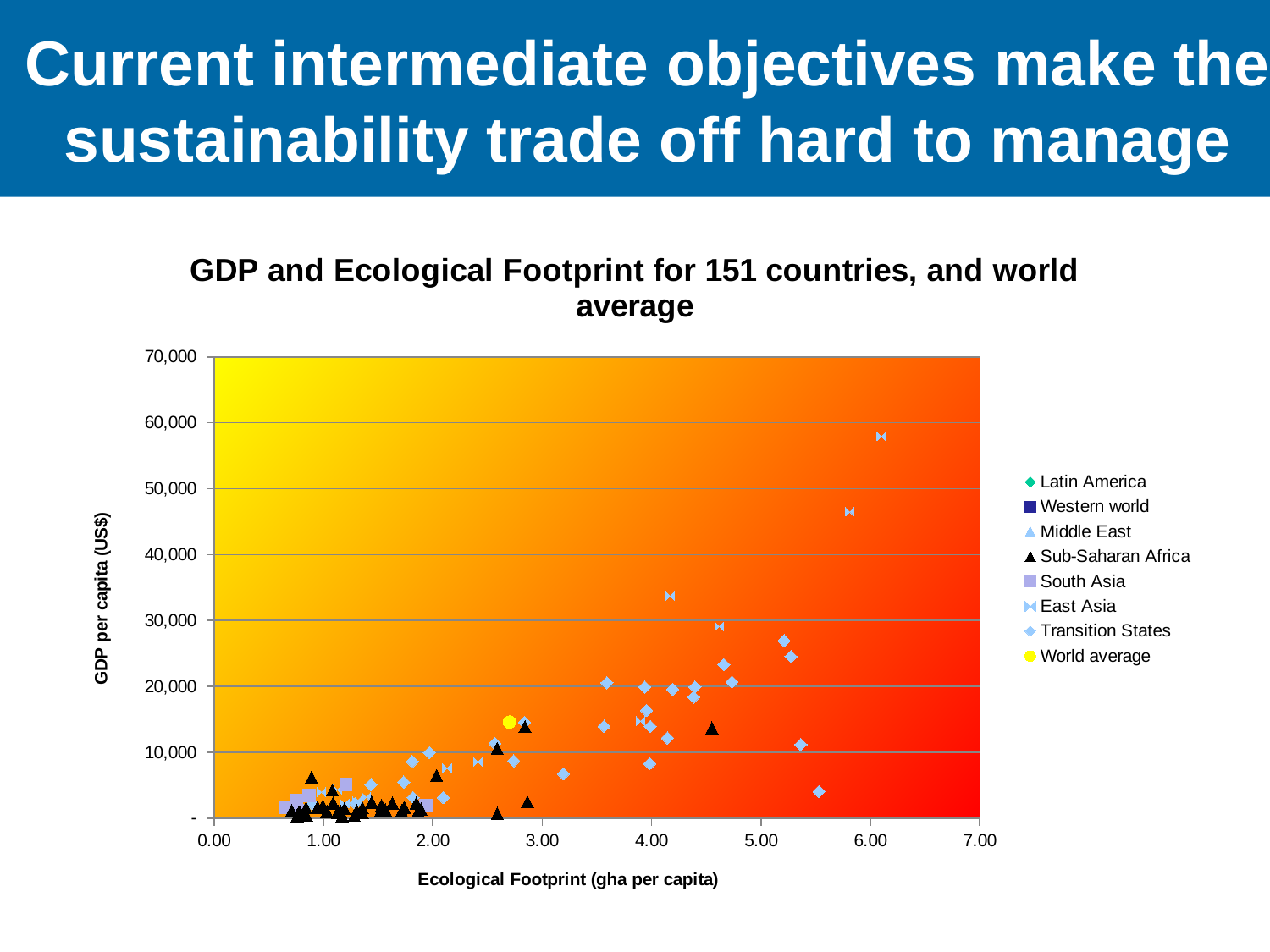
What is the title of the chart? GDP and Ecological Footprint for 151 countries, and world average What kind of chart is shown on the slide? scatter chart Do GDP per capita values generally rise or fall as Ecological Footprint increases along the x axis? rise What is the label of the vertical axis? GDP per capita (US$) Which series contains the point with the highest GDP per capita? East Asia How many series does the legend list? 8 Is the Ecological Footprint of the World average point greater or less than 3.00? less Which series has the higher GDP per capita point: the World average or the highest East Asia point? East Asia Is the GDP per capita of the World average point greater or less than 20,000? less Is the GDP per capita of the World average point greater or less than 10,000? greater